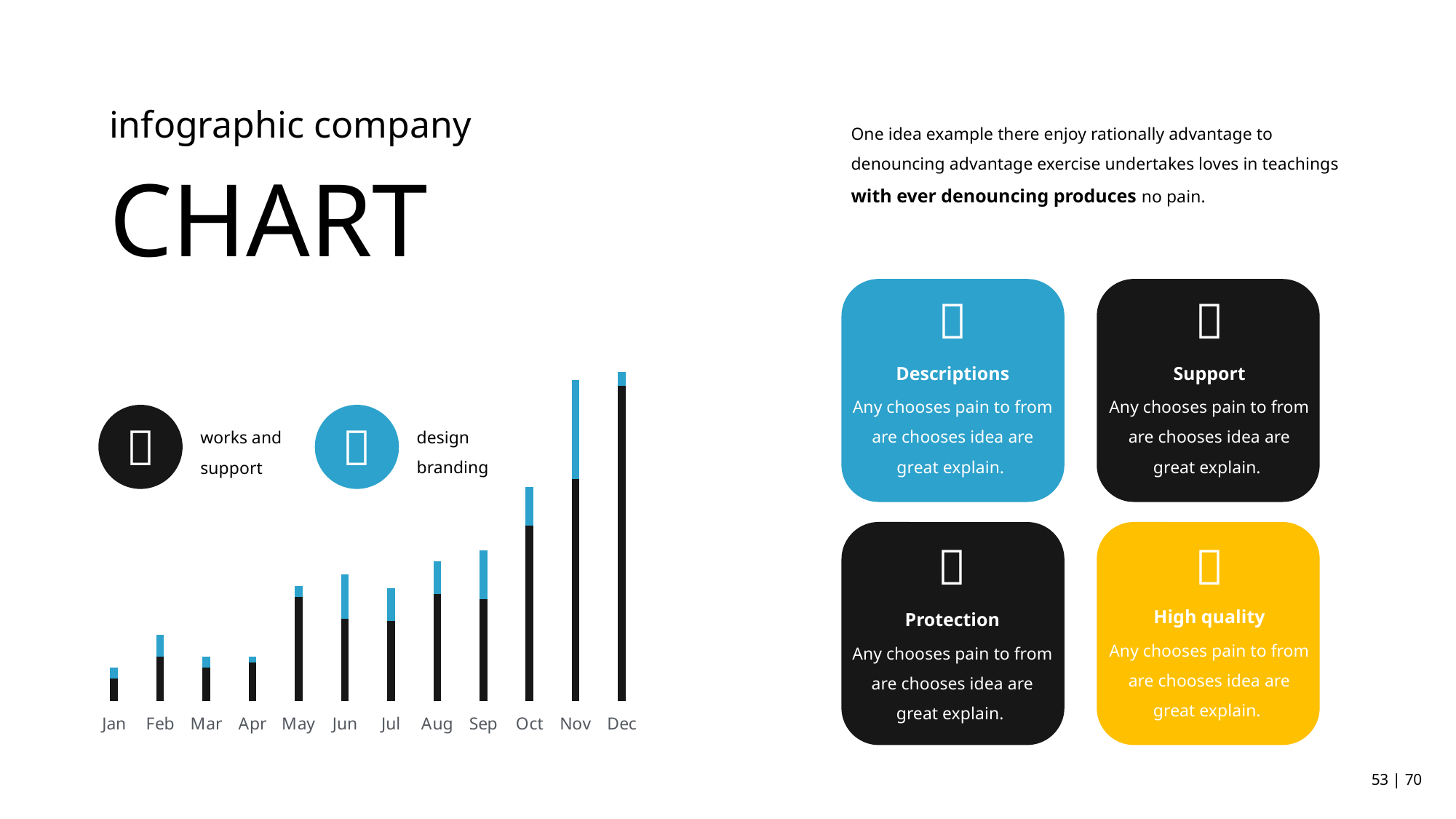
Which colour represents the 'works and support' series in the chart? black Which month has the tallest 'works and support' (black) segment? Dec How many series does the chart's legend list? 2 Do the bar heights generally rise or fall from Jan to Dec? rise What kind of chart is shown on the slide? bar chart Which month's bar is taller, May or Apr? May Which bar is taller, Oct or Sep? Oct Which bar is taller, Nov or Oct? Nov Which colour represents the 'design branding' series in the chart? blue How many months are shown on the x axis of the chart? 12